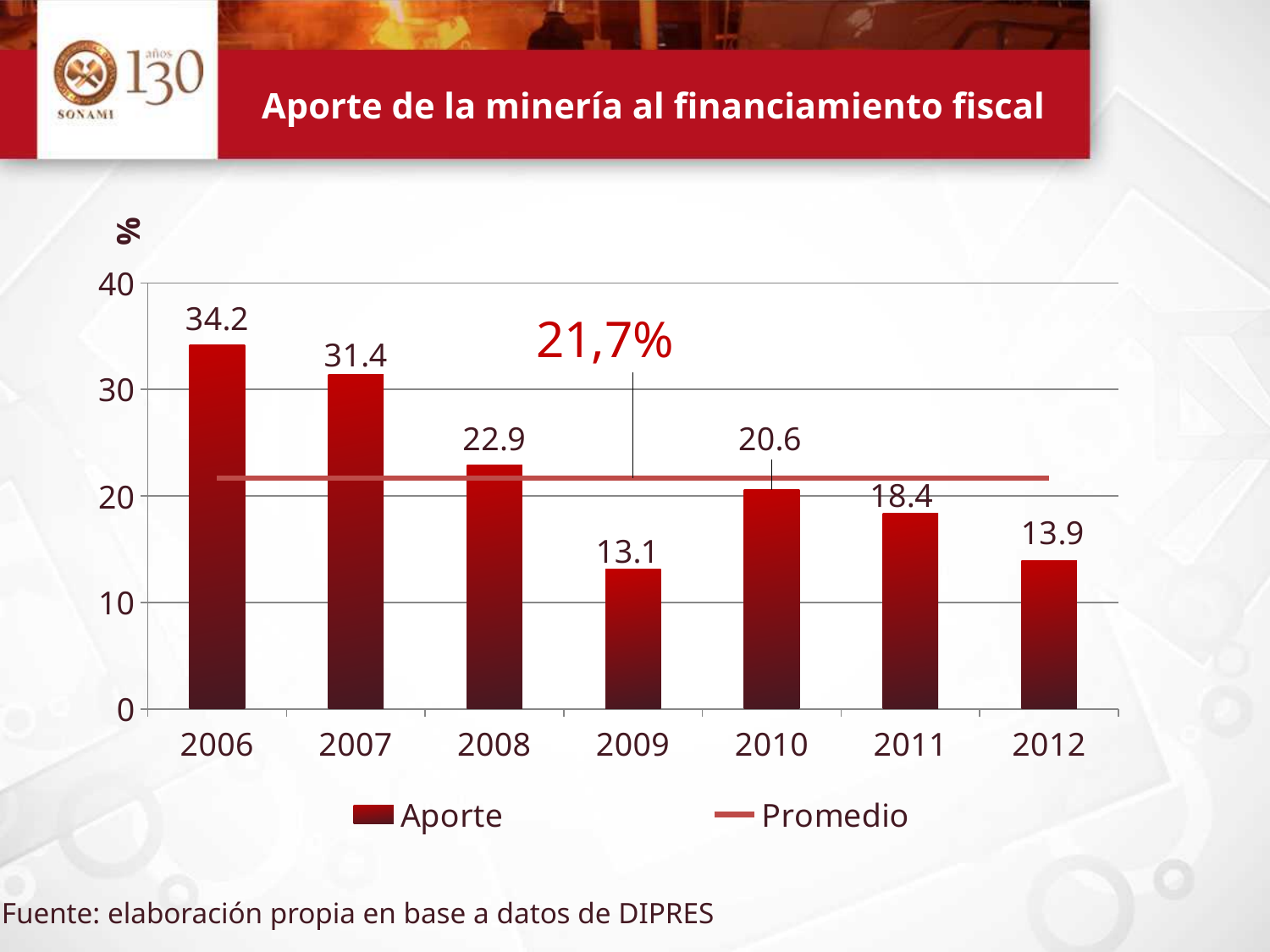
What is the Aporte value for 2012? 13.9 Is the Aporte value for 2008 greater or less than 20? greater Which year has the lowest Aporte value? 2009 Which year has a larger Aporte value, 2010 or 2011? 2010 How many series does the legend list? 2 What value is labelled for the Promedio line? 21,7% What is the Aporte value for 2006? 34.2 Which year has the highest Aporte value? 2006 What kind of chart is used to show the Aporte values? bar chart What is the Aporte value for 2009? 13.1 What is the difference between the Aporte values for 2006 and 2007? 2.8 How many years are shown on the x axis? 7